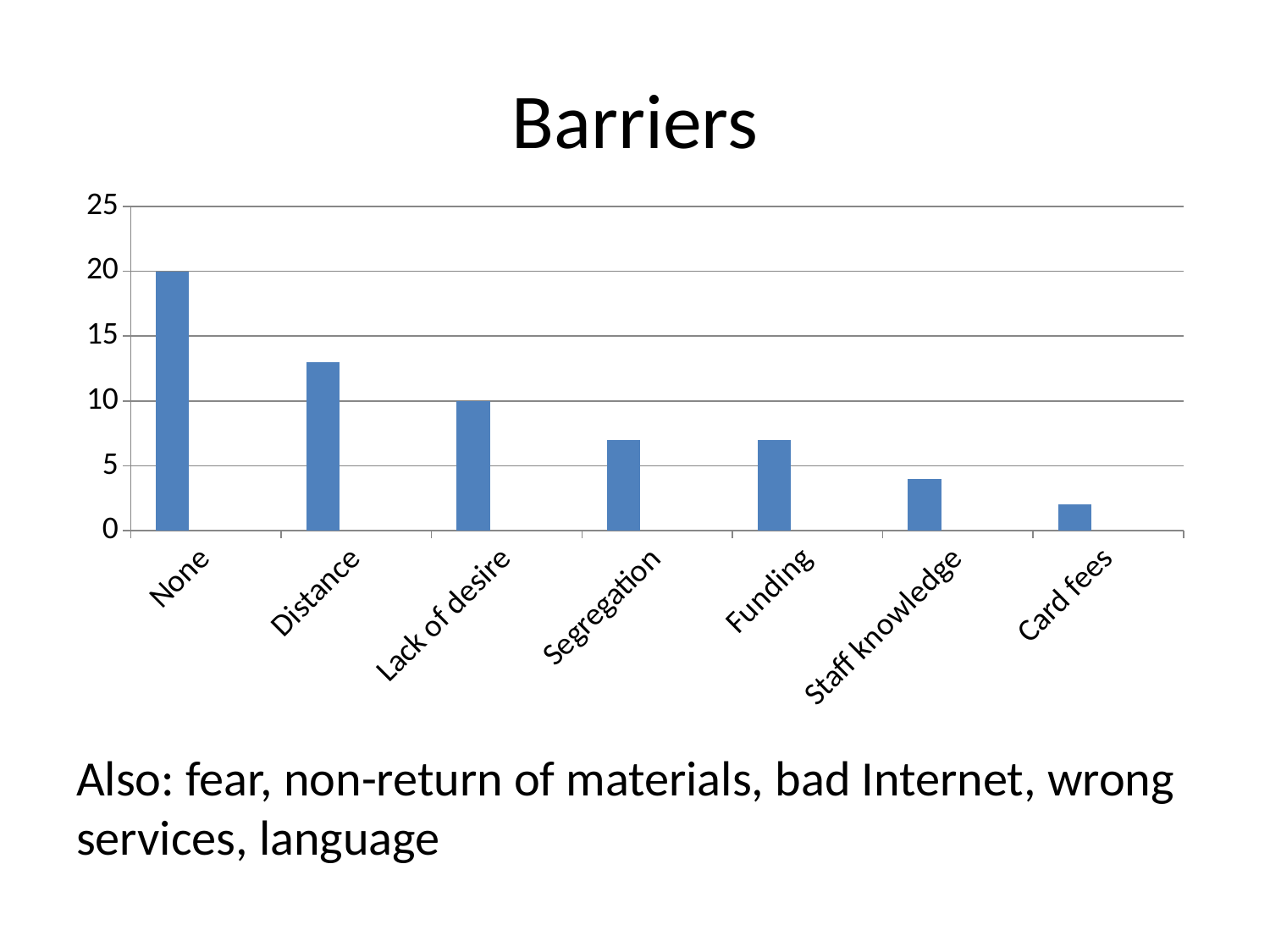
What type of chart is shown on the slide? bar chart Is the value for Segregation greater or less than 10? less How many barrier categories are plotted in the chart? 7 What is the value for Lack of desire? 10 Is the value for Staff knowledge greater or less than 5? less Do the values rise or fall moving from left to right across the categories? fall Is the value for Distance greater or less than 10? greater What is the title of the chart? Barriers Which barrier has the highest value in the chart? None Which barrier has the lowest value in the chart? Card fees What is the value for None? 20 Which is larger, the value for Distance or the value for Funding? Distance